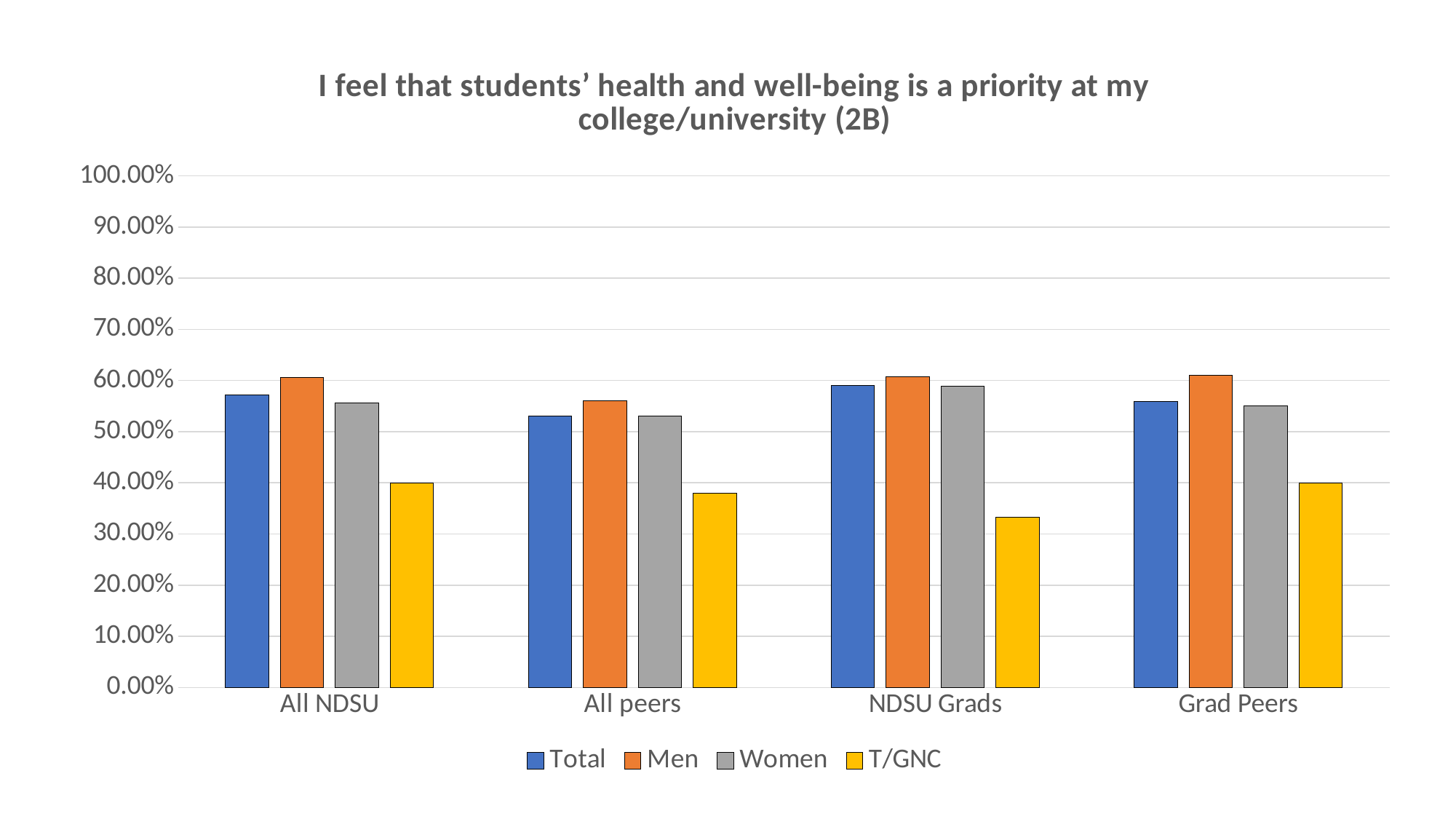
Is the T/GNC value for NDSU Grads greater or less than 40.00%? less Is the Total value for All peers greater or less than 50.00%? greater Which is larger, the Men value for All NDSU or the Total value for All NDSU? Men Is the Men value for Grad Peers greater or less than 60.00%? greater How many series does the legend list? 4 Which series has the highest value in the Grad Peers category? Men Which series has the lowest value in every category? T/GNC What kind of chart is shown on the slide? bar chart In which category is the T/GNC value lowest? NDSU Grads How many categories are shown on the x axis? 4 What colour are the T/GNC bars? yellow